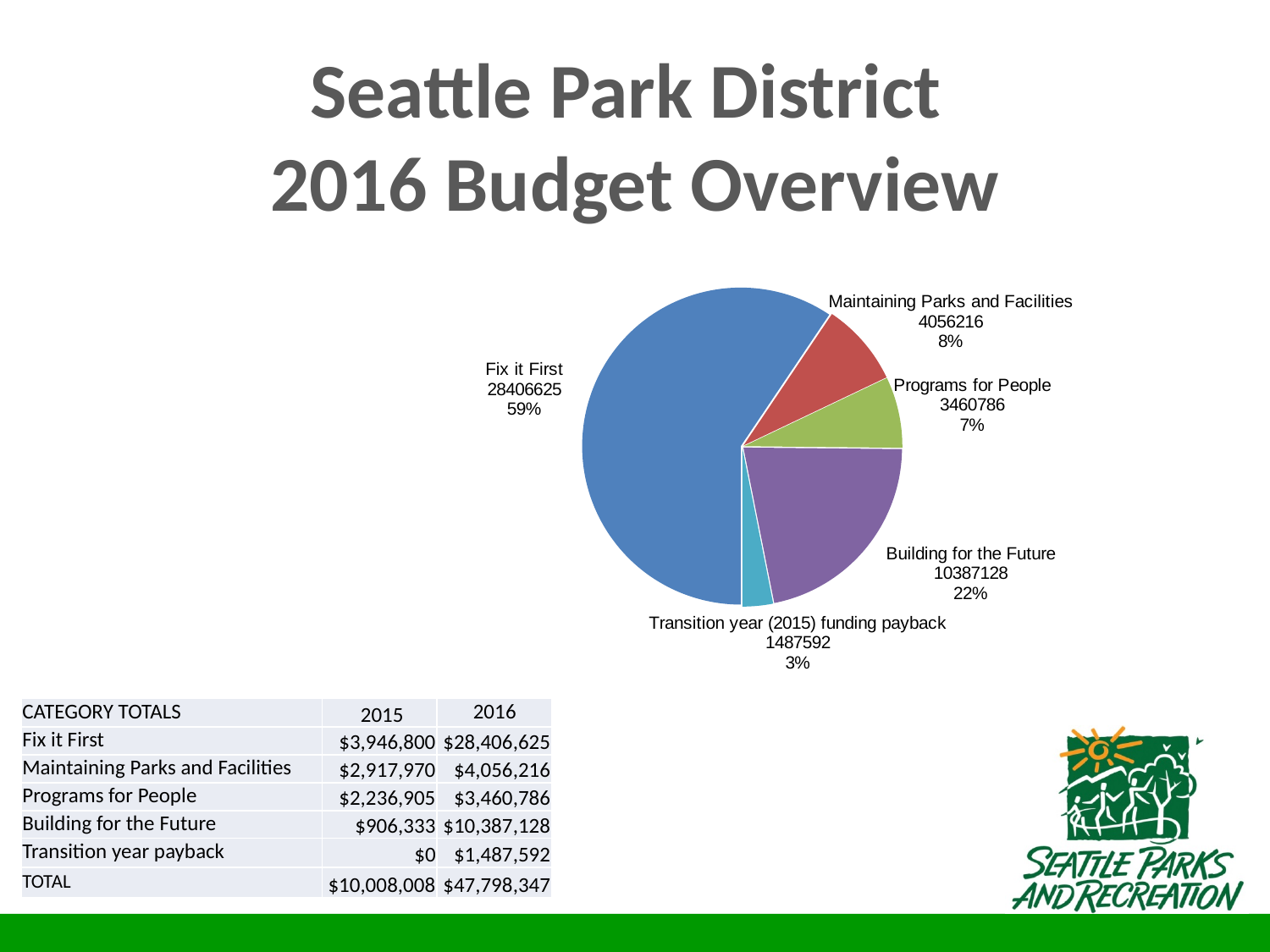
What share of the pie does Programs for People represent? 7% Which category has the largest slice in the pie chart? Fix it First How many slices does the pie chart have? 5 What is the difference between the values for Building for the Future and Maintaining Parks and Facilities in the pie chart? 6330912 What is the value shown for Fix it First in the pie chart? 28406625 What share of the pie does Fix it First represent? 59% What share of the pie does Building for the Future represent? 22% What is the value shown for Building for the Future in the pie chart? 10387128 Which category has the smallest slice in the pie chart? Transition year (2015) funding payback What is the value shown for Transition year (2015) funding payback in the pie chart? 1487592 Which is larger in the pie chart, Maintaining Parks and Facilities or Programs for People? Maintaining Parks and Facilities What type of chart is shown on the slide? pie chart